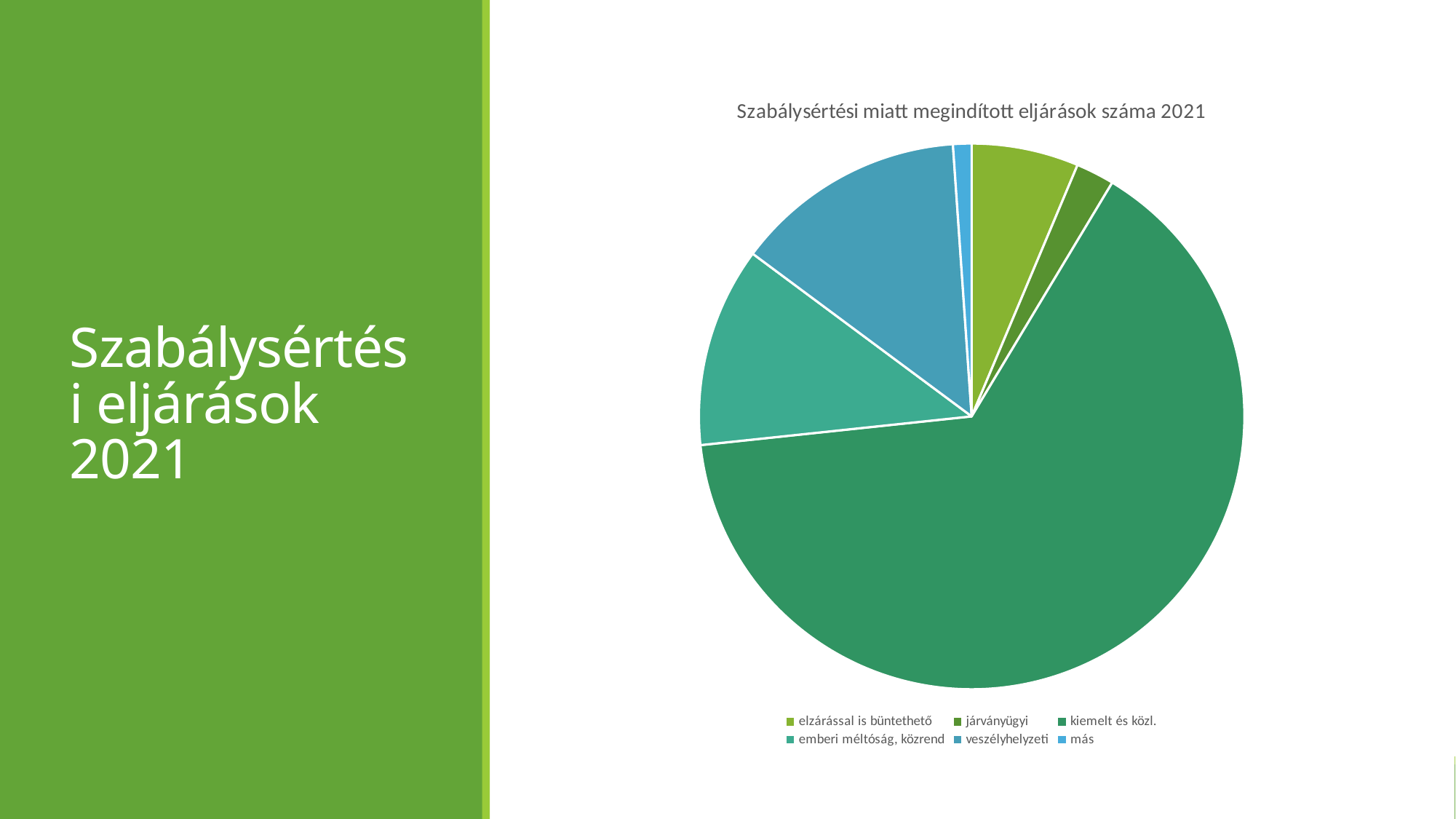
Which legend entry is shown in the lightest blue colour? más Which slice is larger: veszélyhelyzeti or emberi méltóság, közrend? veszélyhelyzeti Which slice is larger: elzárással is büntethető or járványügyi? elzárással is büntethető Which category has the largest slice of the pie? kiemelt és közl. How many categories (slices) does the pie chart have? 6 Does the kiemelt és közl. slice account for more or less than half of the pie? more than half Which category has the smallest slice of the pie? más Which slice is larger: járványügyi or más? járványügyi What is the title of the chart? Szabálysértési miatt megindított eljárások száma 2021 How many entries does the chart legend list? 6 What kind of chart is shown on the slide? pie chart